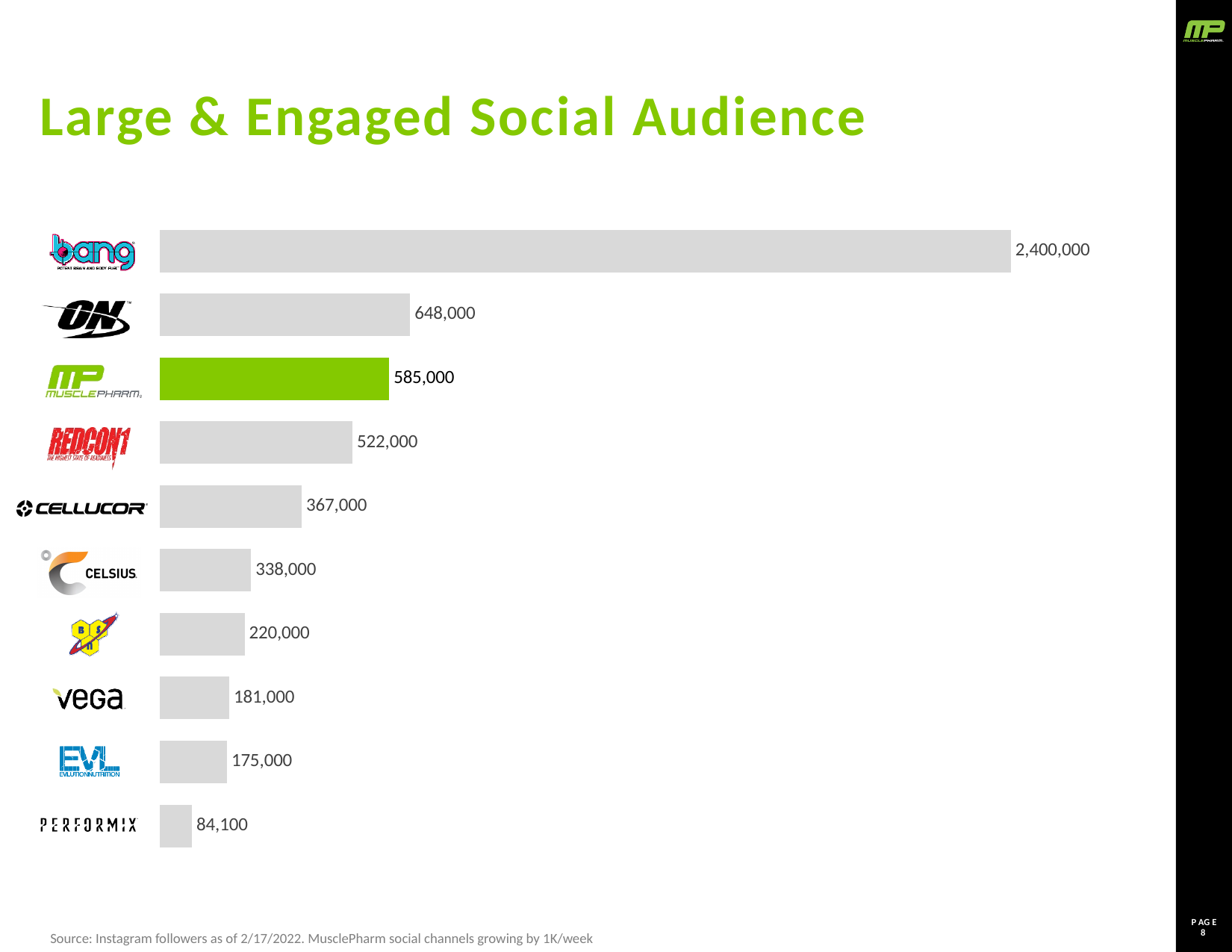
Which brand has the lowest number of Instagram followers? Performix How many Instagram followers does MusclePharm have? 585,000 Which bar in the chart is highlighted in green? MusclePharm What is the difference in followers between MusclePharm and Redcon1? 63,000 How many brands are plotted in the chart? 10 What is the difference in followers between Bang and ON? 1,752,000 Which has more Instagram followers, Celsius or Cellucor? Cellucor Which brand has the highest number of Instagram followers? Bang How many Instagram followers does Cellucor have? 367,000 What kind of chart is shown on the slide? bar chart How many Instagram followers does Redcon1 have? 522,000 Which has more Instagram followers, Vega or EVL? Vega